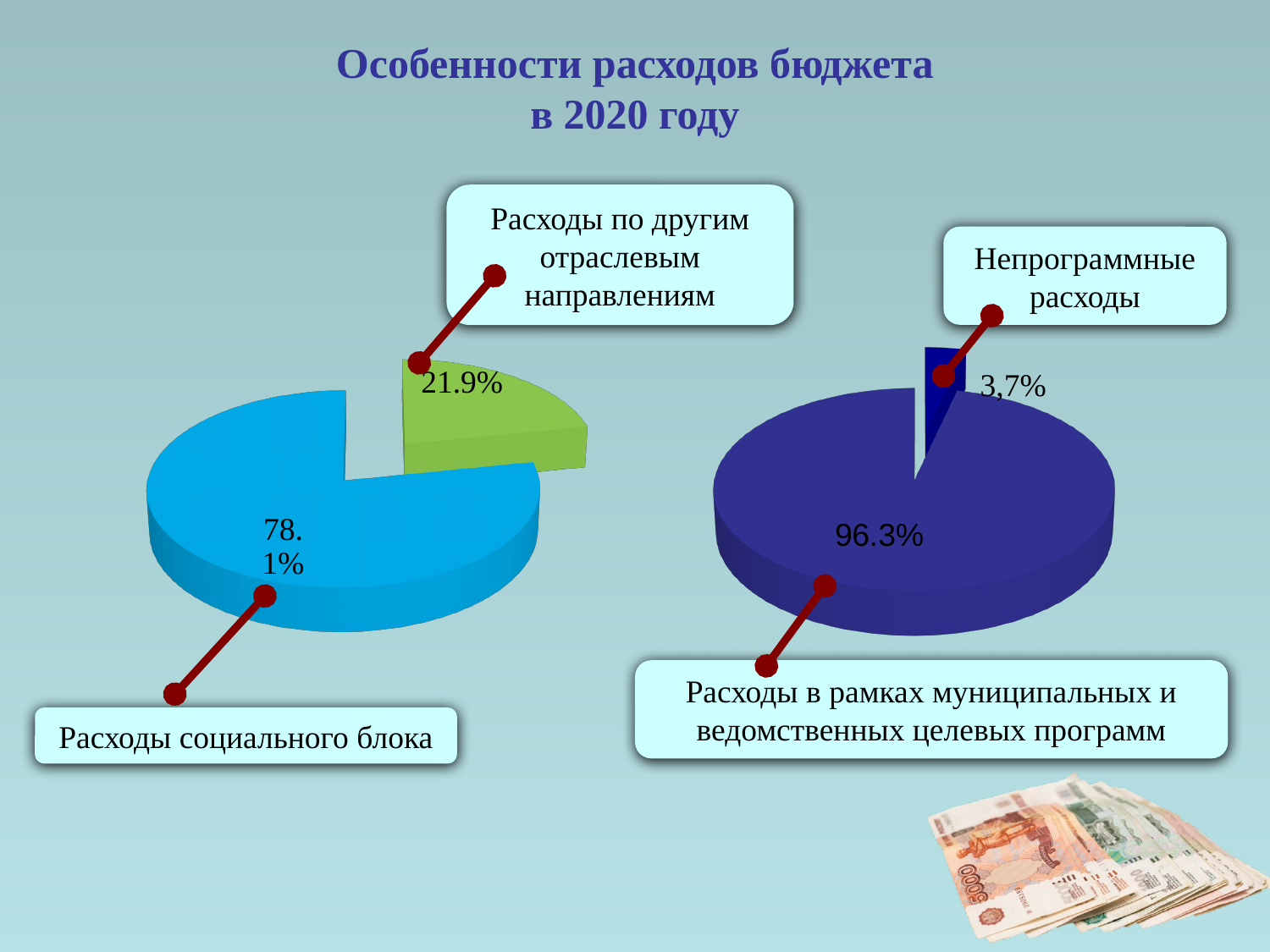
In the right pie chart, which category has the smallest slice? Непрограммные расходы In the left pie chart, what share is shown for Расходы по другим отраслевым направлениям? 21.9% In the right pie chart, what share is shown for Расходы в рамках муниципальных и ведомственных целевых программ? 96.3% What is the title of the slide containing the two pie charts? Особенности расходов бюджета в 2020 году How many slices does the left pie chart have? 2 In the left pie chart, what is the difference in percentage points between Расходы социального блока and Расходы по другим отраслевым направлениям? 56.2 In the left pie chart, what share is shown for Расходы социального блока? 78.1% What type of chart is the right chart on the slide? Pie chart How many slices does the right pie chart have? 2 In the right pie chart, which is larger: Непрограммные расходы or Расходы в рамках муниципальных и ведомственных целевых программ? Расходы в рамках муниципальных и ведомственных целевых программ In the left pie chart, which category has the largest slice? Расходы социального блока In the right pie chart, what share is shown for Непрограммные расходы? 3,7%